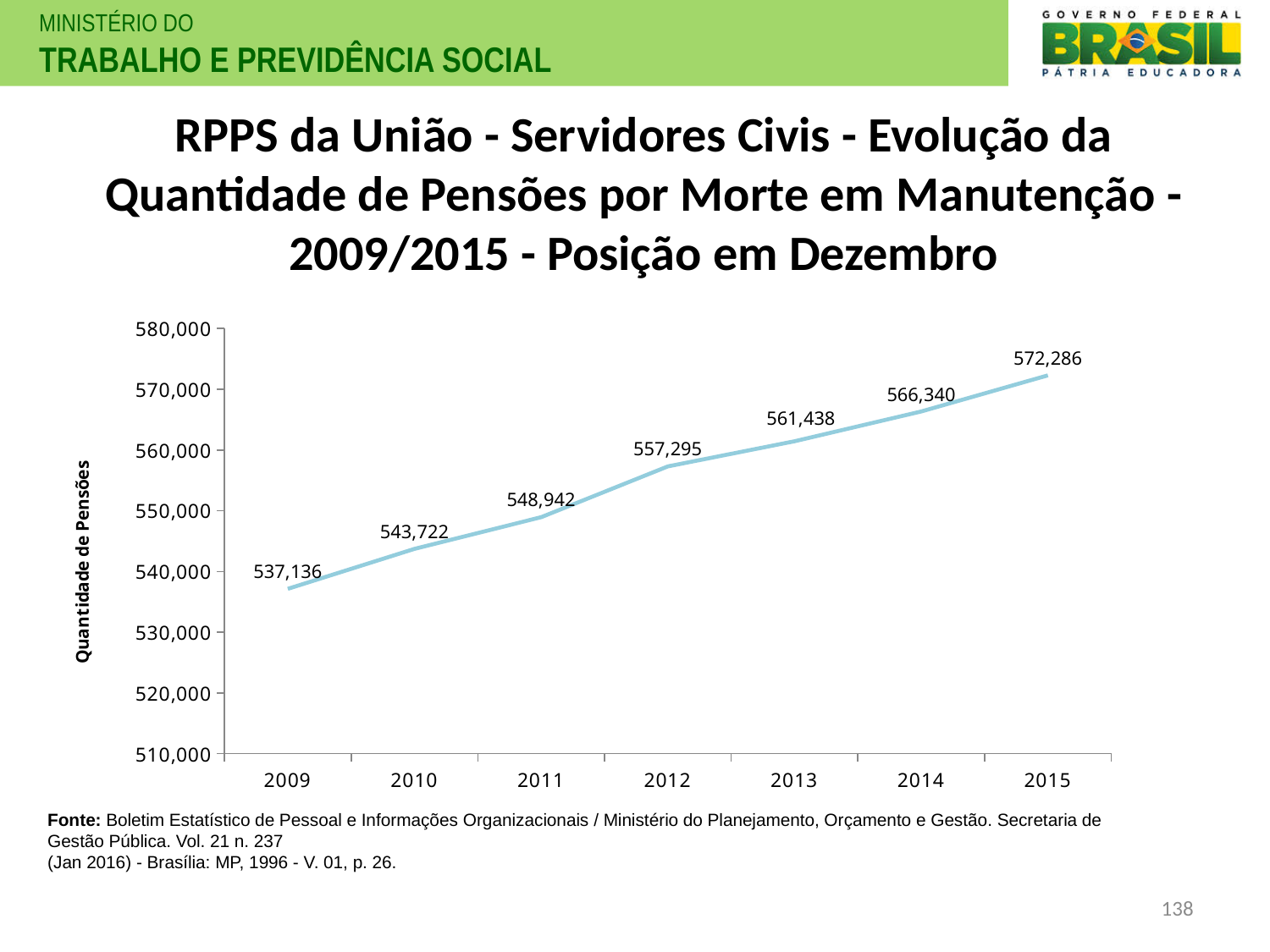
Which year has the highest value? 2015 How many years are plotted on the chart? 7 What is the value for 2012? 557,295 Is the value for 2014 greater or less than 560,000? greater What is the difference between the values for 2011 and 2010? 5,220 Do the values rise or fall from 2009 to 2015? rise What is the value for 2015? 572,286 What is the difference between the values for 2015 and 2009? 35,150 Which is larger, the value for 2013 or the value for 2011? 2013 What kind of chart is shown? line chart Which year has the lowest value? 2009 What is the value for 2009? 537,136